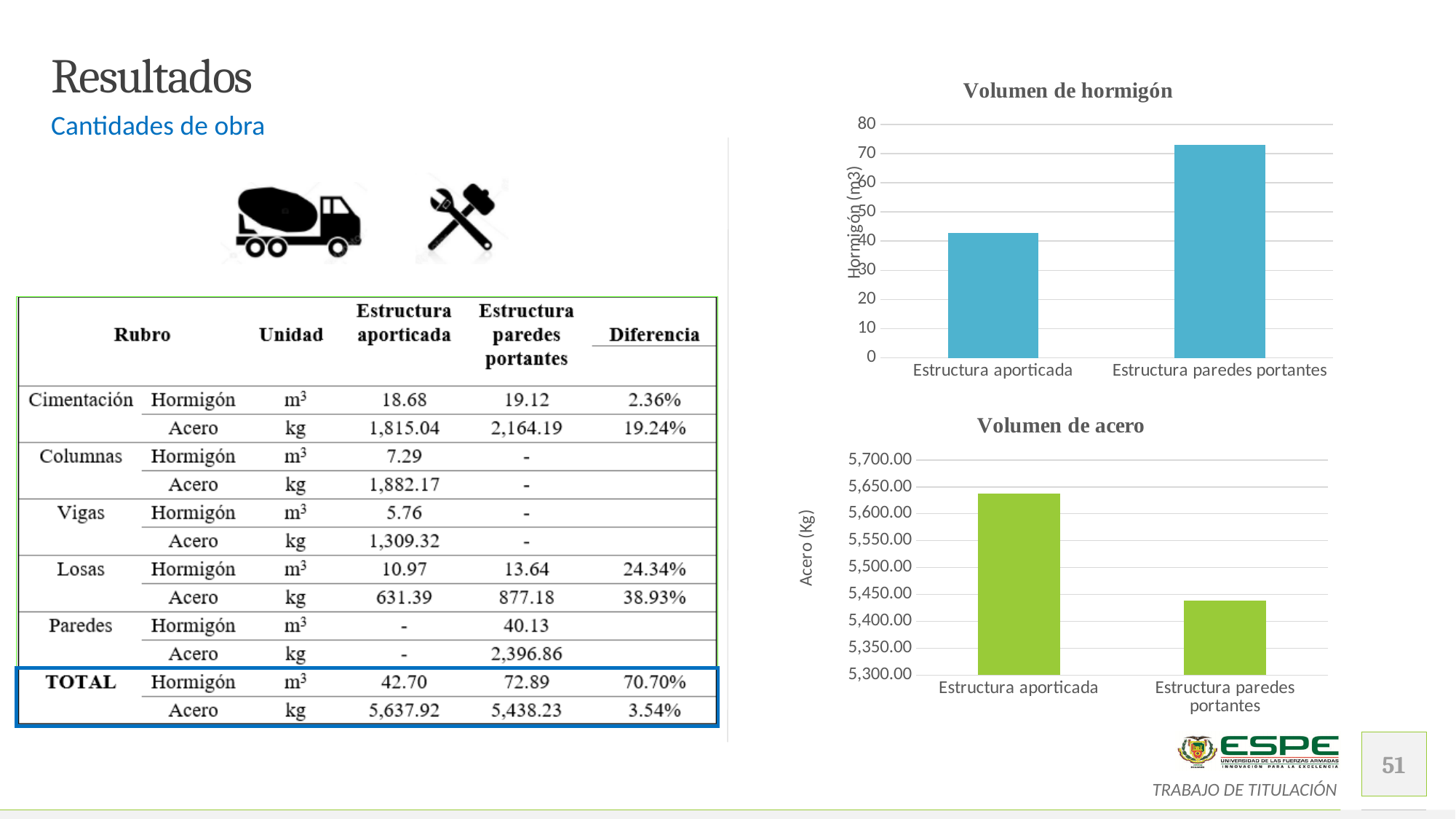
In the 'Volumen de acero' chart, is the value for Estructura paredes portantes greater or less than 5,500.00? less In the 'Volumen de hormigón' chart, which category has the highest value? Estructura paredes portantes How many categories are shown in the 'Volumen de hormigón' chart? 2 In the 'Volumen de hormigón' chart, is the value for Estructura paredes portantes greater or less than 60? greater In the 'Volumen de hormigón' chart, is the value for Estructura aporticada greater or less than 50? less In the 'Volumen de acero' chart, which is larger: Estructura aporticada or Estructura paredes portantes? Estructura aporticada What is the y-axis label of the 'Volumen de acero' chart? Acero (Kg) What kind of chart is 'Volumen de acero'? bar chart In the 'Volumen de acero' chart, which category has the highest value? Estructura aporticada In the 'Volumen de hormigón' chart, which category has the lowest value? Estructura aporticada